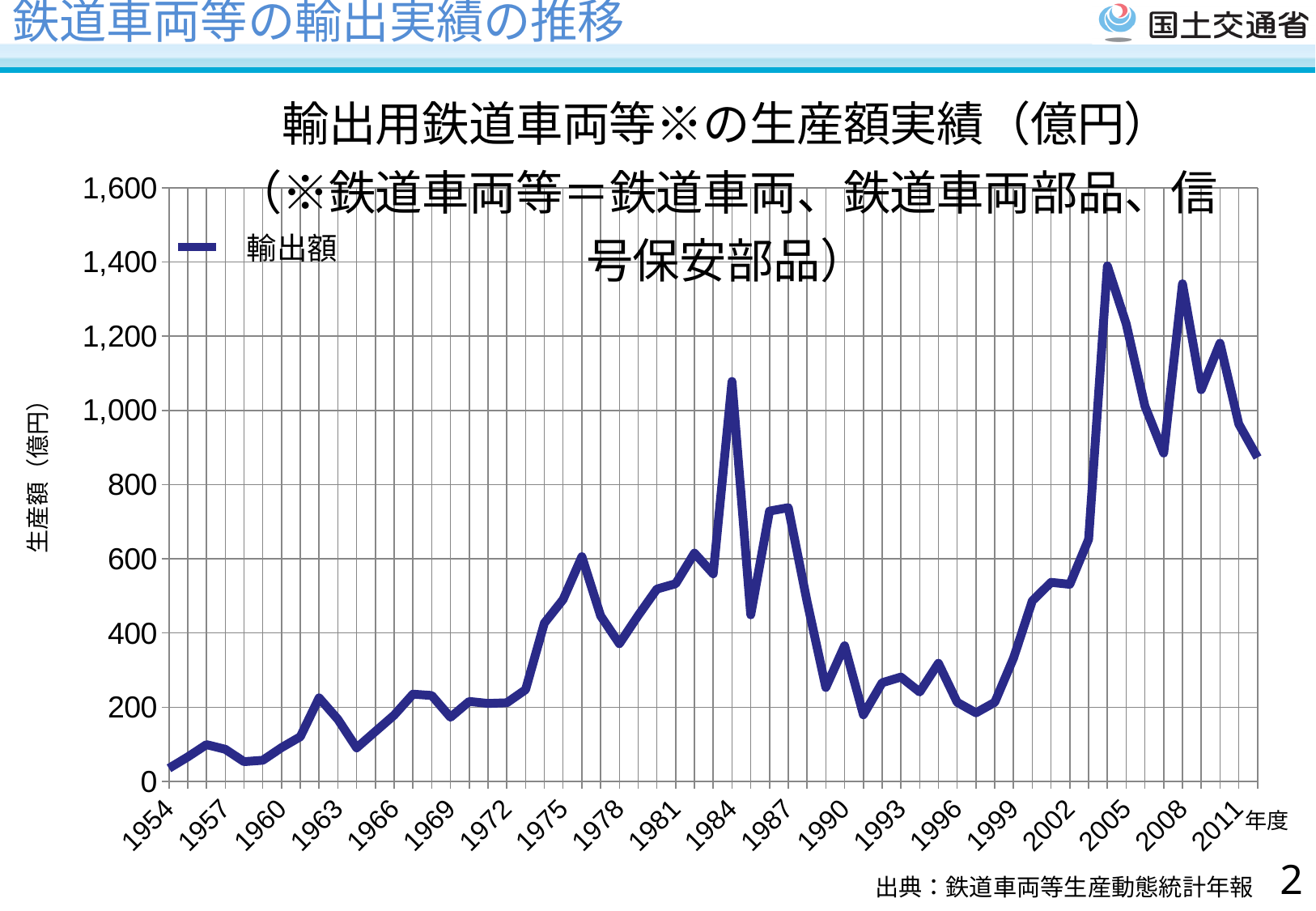
What kind of chart is shown on the slide? line chart In which year is the export value at its lowest? 1954 Is the value for 1984 greater or less than 1,000? greater How many series does the chart legend list? 1 Is the value for 1990 greater or less than 400? less Is the value for 1954 greater or less than 200? less Which year has the larger export value, 1984 or 1987? 1984 What is the label on the vertical axis of the chart? 生産額（億円） In which year does the export value reach its highest point? 2004 What is the name of the series shown in the legend? 輸出額 Overall, does the export value rise or fall from 1954 to 2005? rise